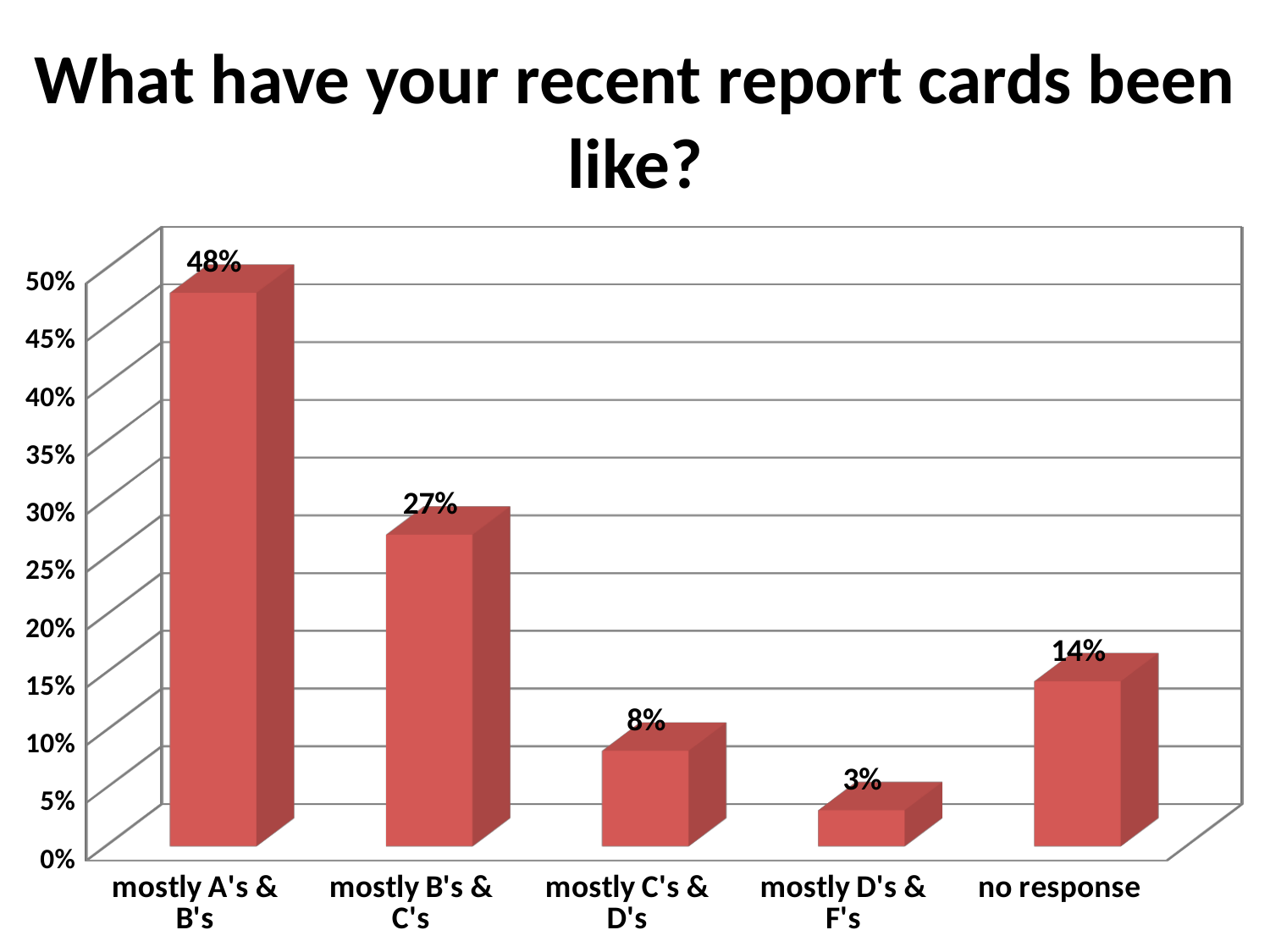
What is the difference between the values for no response and mostly C's & D's? 6% What percentage of respondents gave no response? 14% What is the value for mostly C's & D's? 8% Which category has the highest value? mostly A's & B's What is the title of the chart? What have your recent report cards been like? What is the difference between the values for mostly A's & B's and mostly B's & C's? 21% What percentage of respondents reported mostly A's & B's? 48% What kind of chart is shown on the slide? bar chart How many categories are shown on the x axis? 5 Which category has the lowest value? mostly D's & F's Which is larger, the value for no response or the value for mostly C's & D's? no response What is the value for mostly B's & C's? 27%